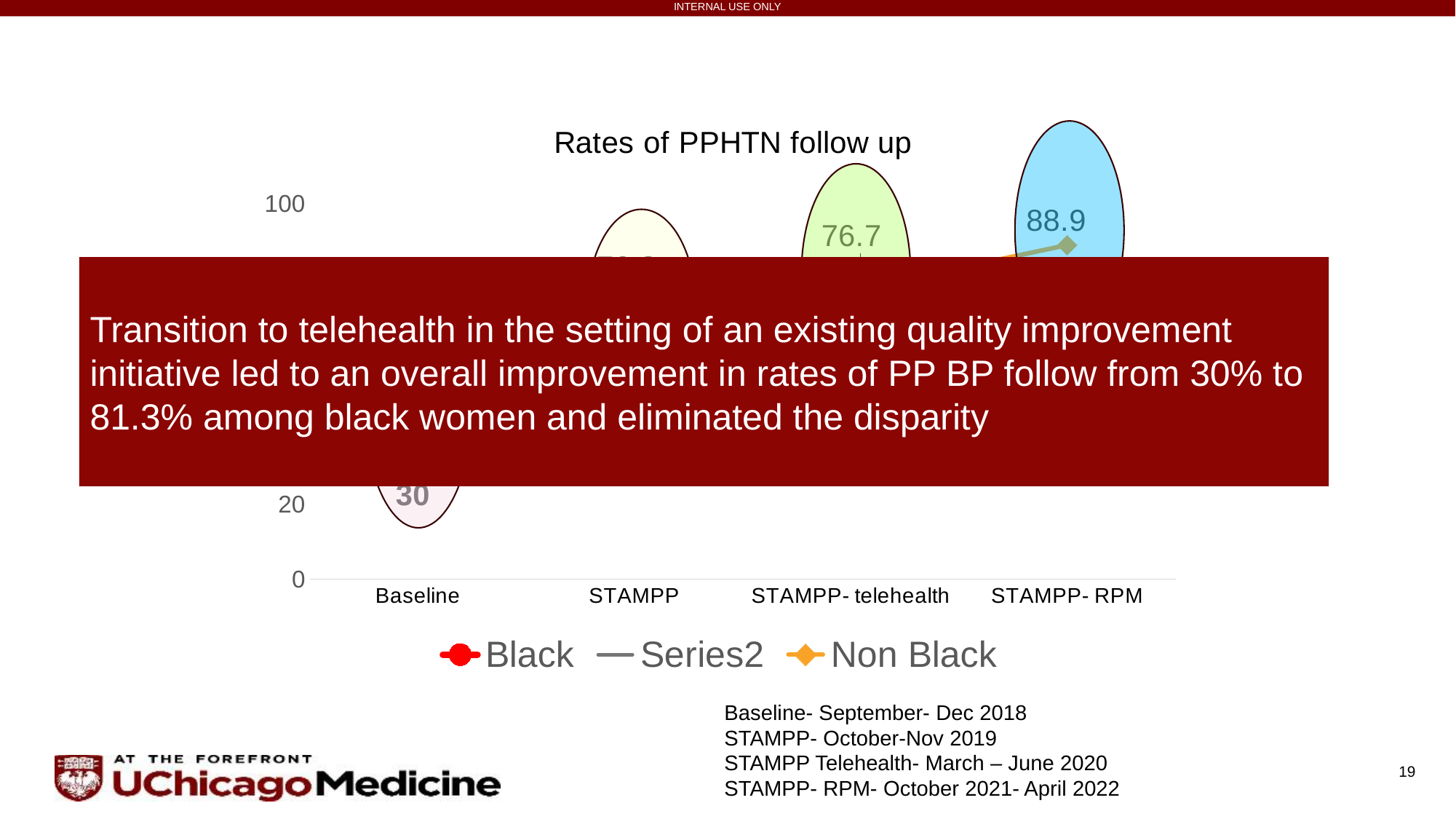
What is the title of the chart? Rates of PPHTN follow up Is the value for Non Black at STAMPP- RPM greater or less than 80? greater What is the value for Non Black at STAMPP- telehealth? 76.7 What kind of chart is shown on the slide? line chart What is the value for Non Black at STAMPP- RPM? 88.9 Which series in the legend is shown with a red circle marker? Black How many series does the chart legend list? 3 Which is larger for Non Black: the value at STAMPP- telehealth or at STAMPP- RPM? STAMPP- RPM Is the value for Black at Baseline greater or less than 40? less How many categories are shown on the x axis of the chart? 4 What is the difference between the Non Black values at STAMPP- RPM and STAMPP- telehealth? 12.2 What is the value for Black at Baseline? 30